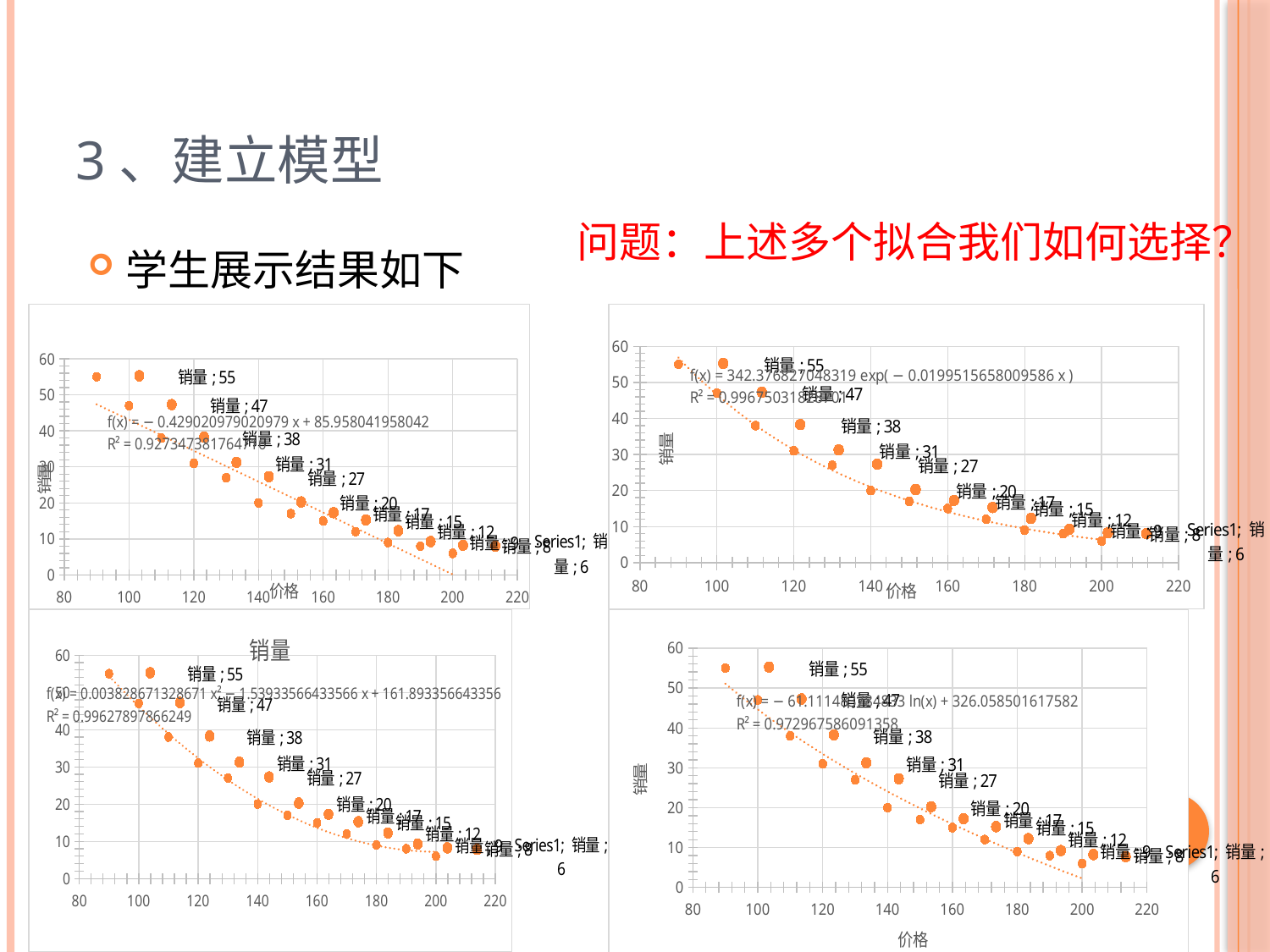
In the top-left chart, what is the highest labelled 销量 value? 55 In the top-right chart, what is the lowest labelled 销量 value? 6 In the top-left chart, what is the difference between the two highest labelled 销量 values, 55 and 47? 8 What is the x-axis title of the bottom-right chart? 价格 In the top-right chart, which is larger, the labelled 销量 value 38 or the labelled 销量 value 31? 38 In the bottom-right chart, is the 销量 value at 价格 90 greater or less than 50? greater In the bottom-right chart, do the 销量 values rise or fall as 价格 increases along the x axis? fall What is the R² value printed on the bottom-left chart? 0.99627897866249 In the bottom-left chart, how many labelled data points are shown? 12 What kind of chart is the top-left chart on the slide? scatter chart In the bottom-left chart, is the 销量 value at 价格 200 greater or less than 20? less